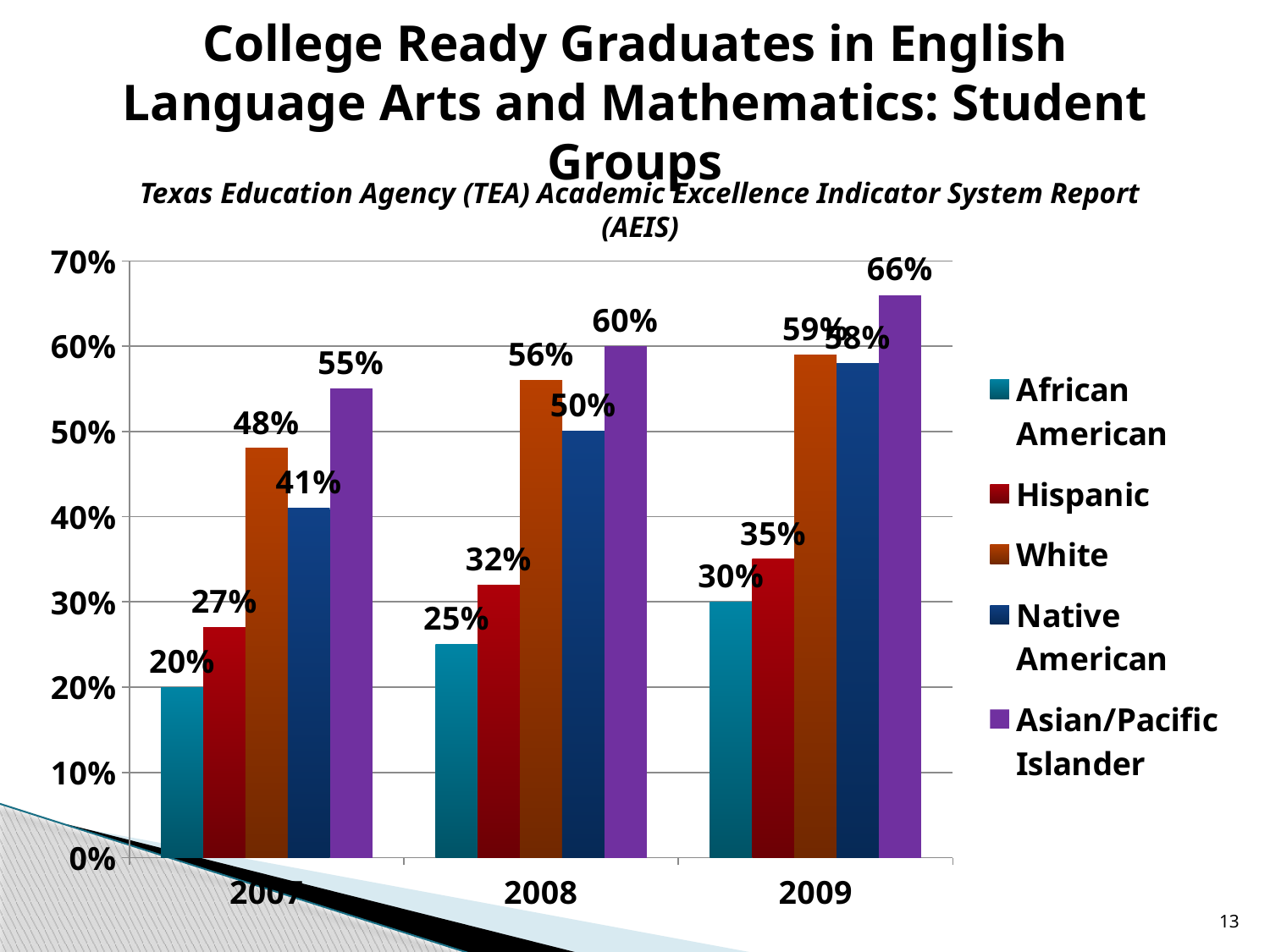
Which student group has the lowest value in 2009? African American Which is larger in 2008: the Hispanic value or the Native American value? Native American What is the difference between the Asian/Pacific Islander value and the African American value in 2007? 35% How many student groups does the legend list? 5 What is the value for Asian/Pacific Islander in 2009? 66% What is the value for Native American in 2007? 41% Which student group has the highest value in 2008? Asian/Pacific Islander Does the African American value rise or fall from 2007 to 2009? rise What kind of chart is shown on the slide? bar chart What is the value for White in 2008? 56% How many years are shown on the x axis? 3 What is the value for African American in 2007? 20%